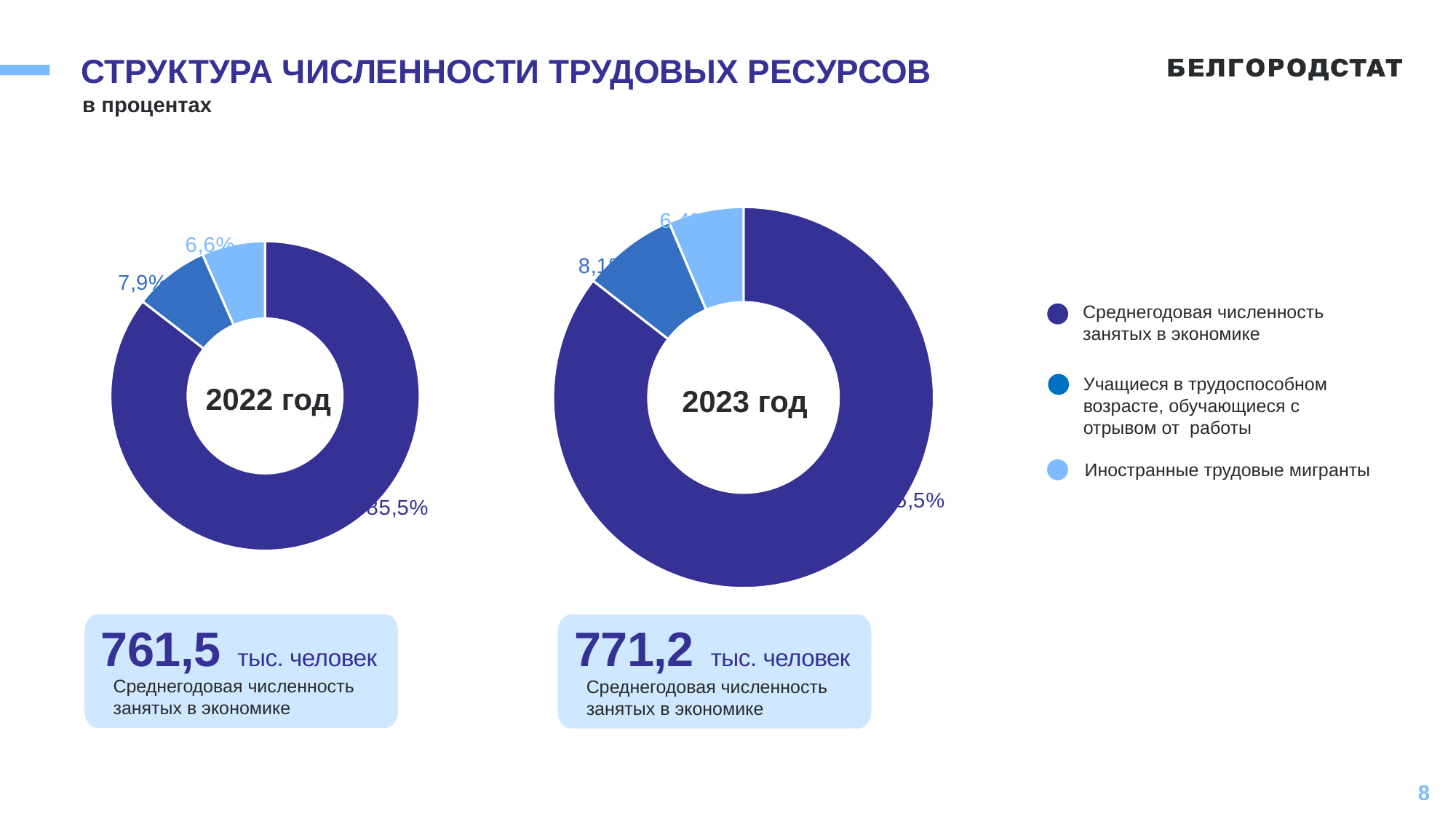
In the 2022 год chart, what is the difference in percentage points between Учащиеся в трудоспособном возрасте and Иностранные трудовые мигранты? 1,3 In the 2022 год chart, which category has the smallest share? Иностранные трудовые мигранты In the 2023 год chart, which is larger: the share for Среднегодовая численность занятых в экономике or for Учащиеся в трудоспособном возрасте? Среднегодовая численность занятых в экономике How many categories does the legend list? 3 In the 2022 год chart, what share is shown for Иностранные трудовые мигранты? 6,6% How many slices does the 2023 год chart have? 3 In the 2022 год chart, which is larger: the share for Учащиеся в трудоспособном возрасте or for Иностранные трудовые мигранты? Учащиеся в трудоспособном возрасте In the 2022 год chart, what share is shown for Среднегодовая численность занятых в экономике? 85,5% What kind of chart is used to show the 2022 год data? doughnut chart In the 2022 год chart, what share is shown for Учащиеся в трудоспособном возрасте, обучающиеся с отрывом от работы? 7,9% In the 2022 год chart, which category has the largest share? Среднегодовая численность занятых в экономике What is the title of the slide containing the two charts? СТРУКТУРА ЧИСЛЕННОСТИ ТРУДОВЫХ РЕСУРСОВ